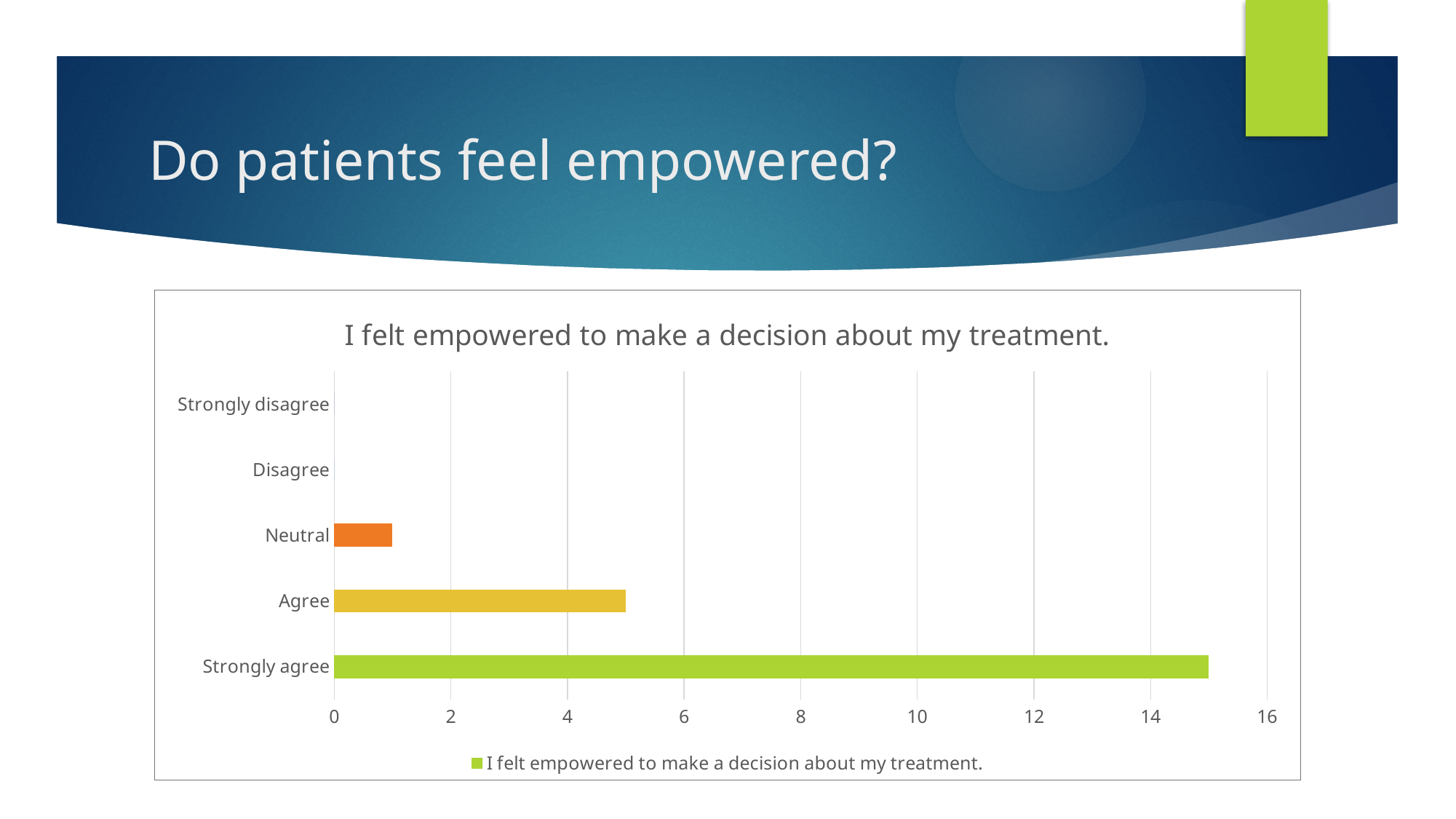
Which has the larger value, Strongly agree or Agree? Strongly agree What is the title of the chart? I felt empowered to make a decision about my treatment. How many series does the chart's legend list? 1 What colour is the bar for Strongly agree? green How many response categories are listed on the vertical axis of the chart? 5 Is the value for Strongly agree greater or less than 14? greater Is the value for Agree greater or less than 4? greater Is the value for Neutral greater or less than 2? less Which response category has the highest value in the chart? Strongly agree What kind of chart is shown on the slide? bar chart Which has the larger value, Agree or Neutral? Agree